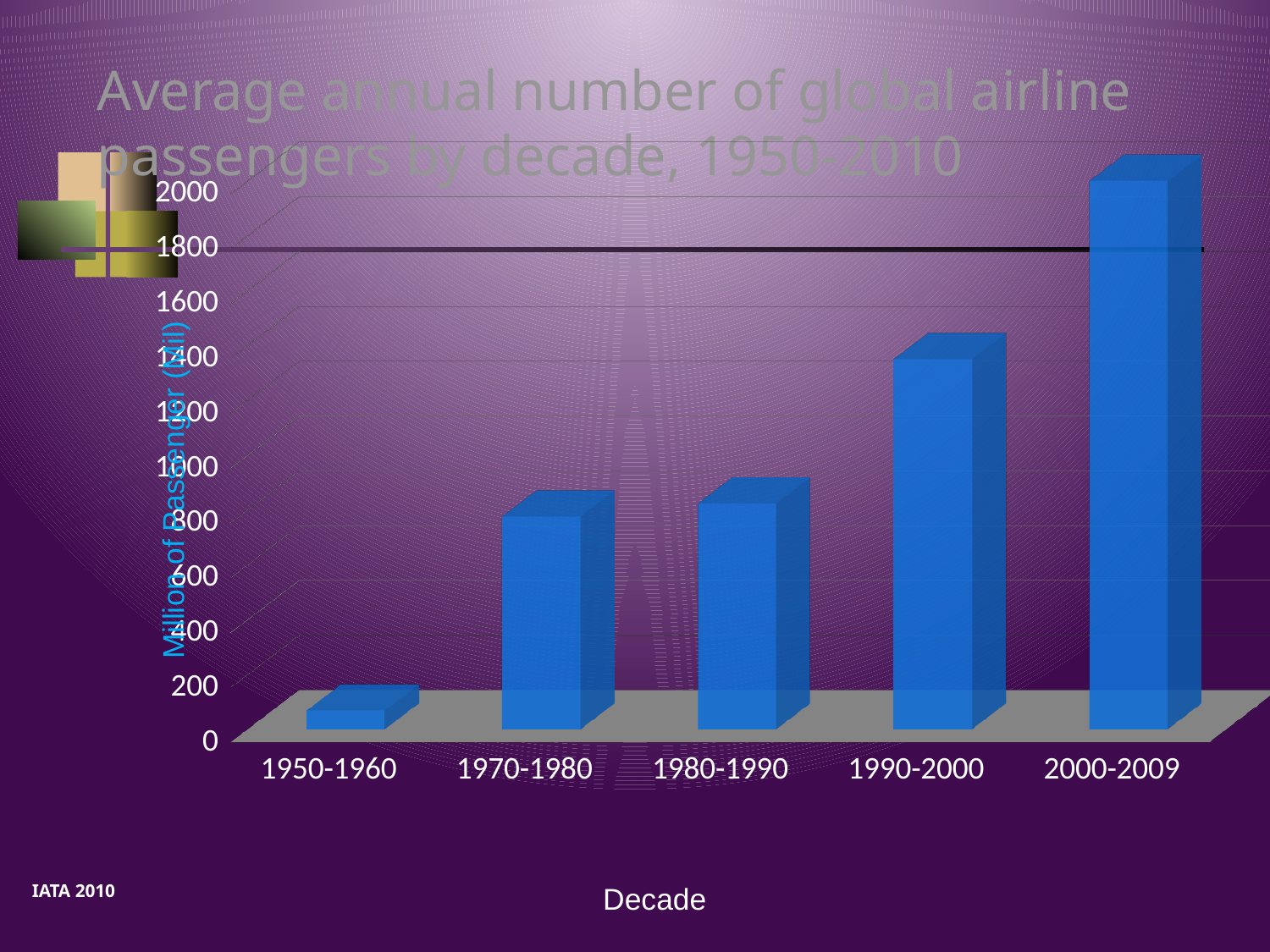
Is the value for 1970-1980 greater or less than 1000? less Which decade has the highest average annual number of global airline passengers? 2000-2009 Is the value for 1950-1960 greater or less than 200? less Which is larger, the value for 1990-2000 or the value for 1980-1990? 1990-2000 Is the value for 1990-2000 greater or less than 1200? greater Do the values rise or fall from 1950-1960 to 2000-2009 along the x axis? rise What is the label of the x axis? Decade How many decade categories are shown on the x axis? 5 Which decade has the lowest average annual number of global airline passengers? 1950-1960 What is the title of the chart? Average annual number of global airline passengers by decade, 1950-2010 What kind of chart is shown on the slide? bar chart